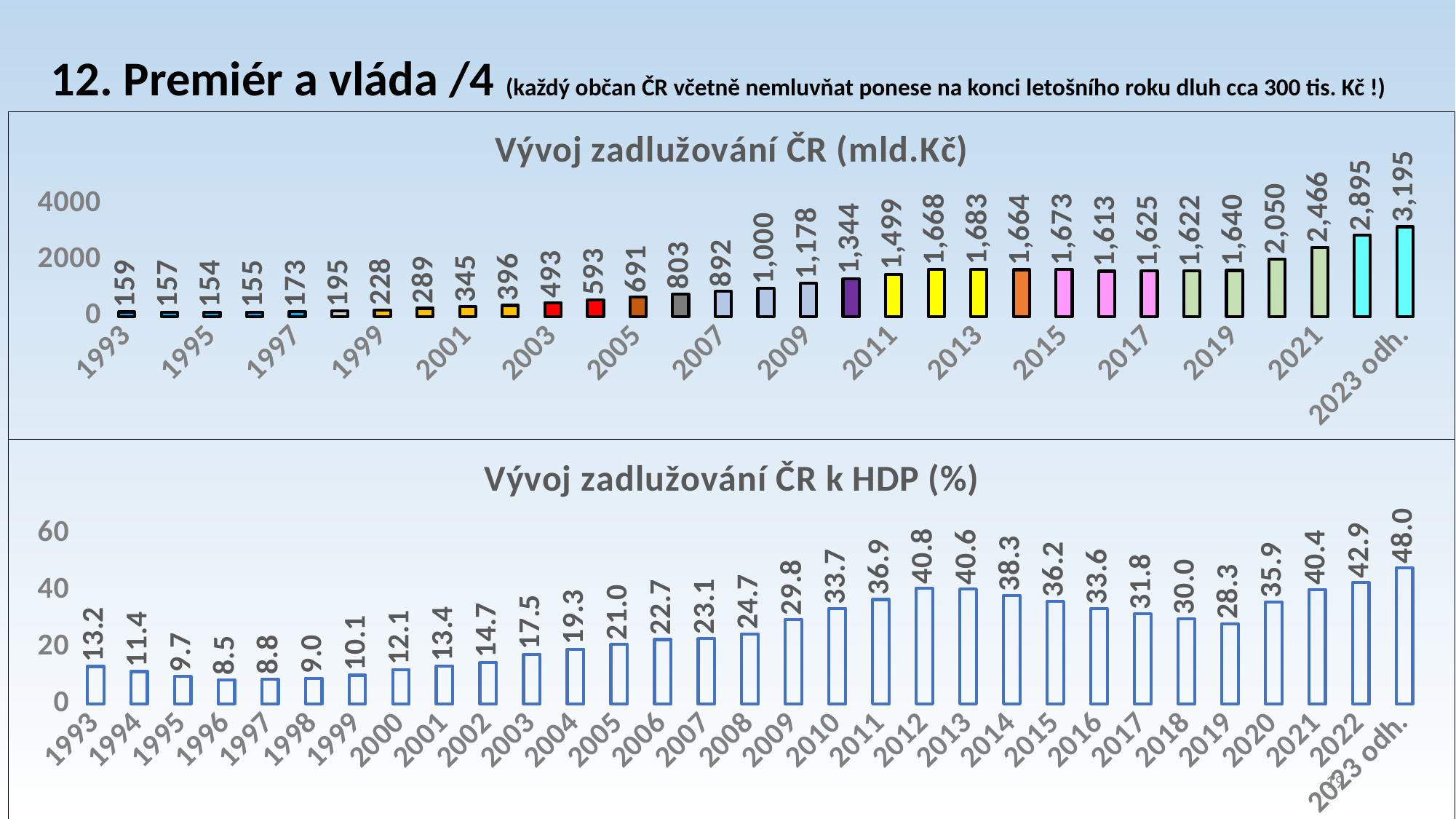
In the chart 'Vývoj zadlužování ČR (mld.Kč)', what is the value for 2011? 1,499 In the chart 'Vývoj zadlužování ČR (mld.Kč)', what is the difference between the values for 2021 and 2019? 826 In the chart 'Vývoj zadlužování ČR k HDP (%)', which is larger, the value for 2013 or the value for 2019? 2013 In the chart 'Vývoj zadlužování ČR k HDP (%)', what is the difference between the values for 2023 odh. and 2022? 5.1 How many bars are plotted in the chart 'Vývoj zadlužování ČR k HDP (%)'? 31 In the chart 'Vývoj zadlužování ČR k HDP (%)', which year has the highest value? 2023 odh. In the chart 'Vývoj zadlužování ČR k HDP (%)', what is the value for 2012? 40.8 In the chart 'Vývoj zadlužování ČR k HDP (%)', what is the value for 1996? 8.5 What type of chart is 'Vývoj zadlužování ČR (mld.Kč)'? Bar chart In the chart 'Vývoj zadlužování ČR (mld.Kč)', is the value for 2021 greater or less than 2000? greater In the chart 'Vývoj zadlužování ČR (mld.Kč)', which year has the lowest value? 1995 In the chart 'Vývoj zadlužování ČR (mld.Kč)', what is the value for 2023 odh.? 3,195